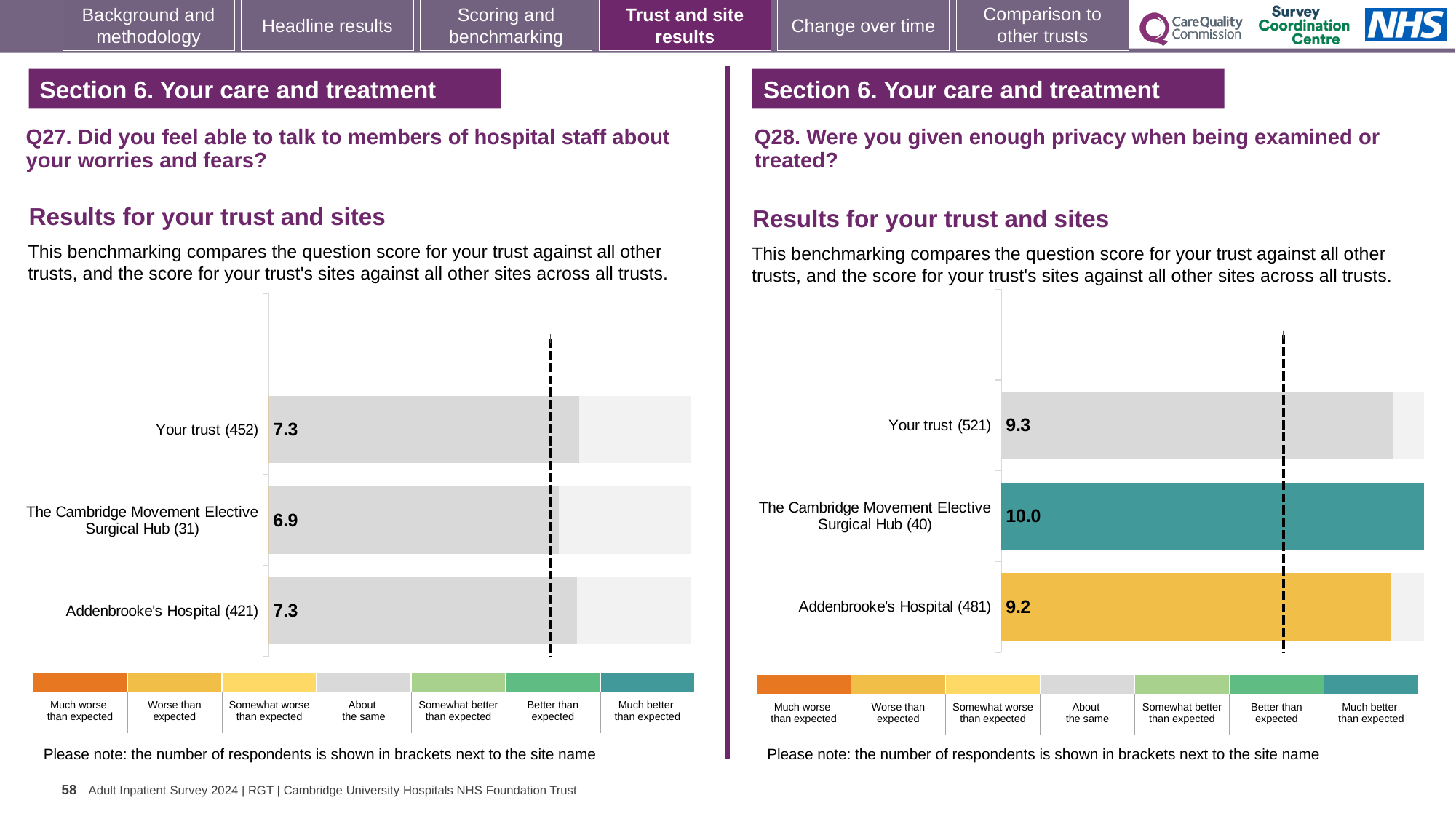
In the Q27 chart (left), what is the difference between the score for Your trust and the score for The Cambridge Movement Elective Surgical Hub? 0.4 In the Q28 chart (right), which has the larger score: Your trust or Addenbrooke's Hospital? Your trust In the Q27 chart (left), what is the score for The Cambridge Movement Elective Surgical Hub? 6.9 What kind of chart is used for the Q28 results (right)? Bar chart How many bars are plotted in the Q27 chart (left)? 3 In the Q28 chart (right), what is the score for The Cambridge Movement Elective Surgical Hub? 10.0 In the Q28 chart (right), what is the score for Addenbrooke's Hospital? 9.2 In the Q28 chart (right), which site or trust has the highest score? The Cambridge Movement Elective Surgical Hub In the Q28 chart (right), what is the difference between the score for The Cambridge Movement Elective Surgical Hub and the score for Addenbrooke's Hospital? 0.8 In the Q28 chart (right), how many respondents are shown in brackets for Your trust? 521 In the Q27 chart (left), which site or trust has the lowest score? The Cambridge Movement Elective Surgical Hub In the Q27 chart (left), what is the score for Your trust? 7.3